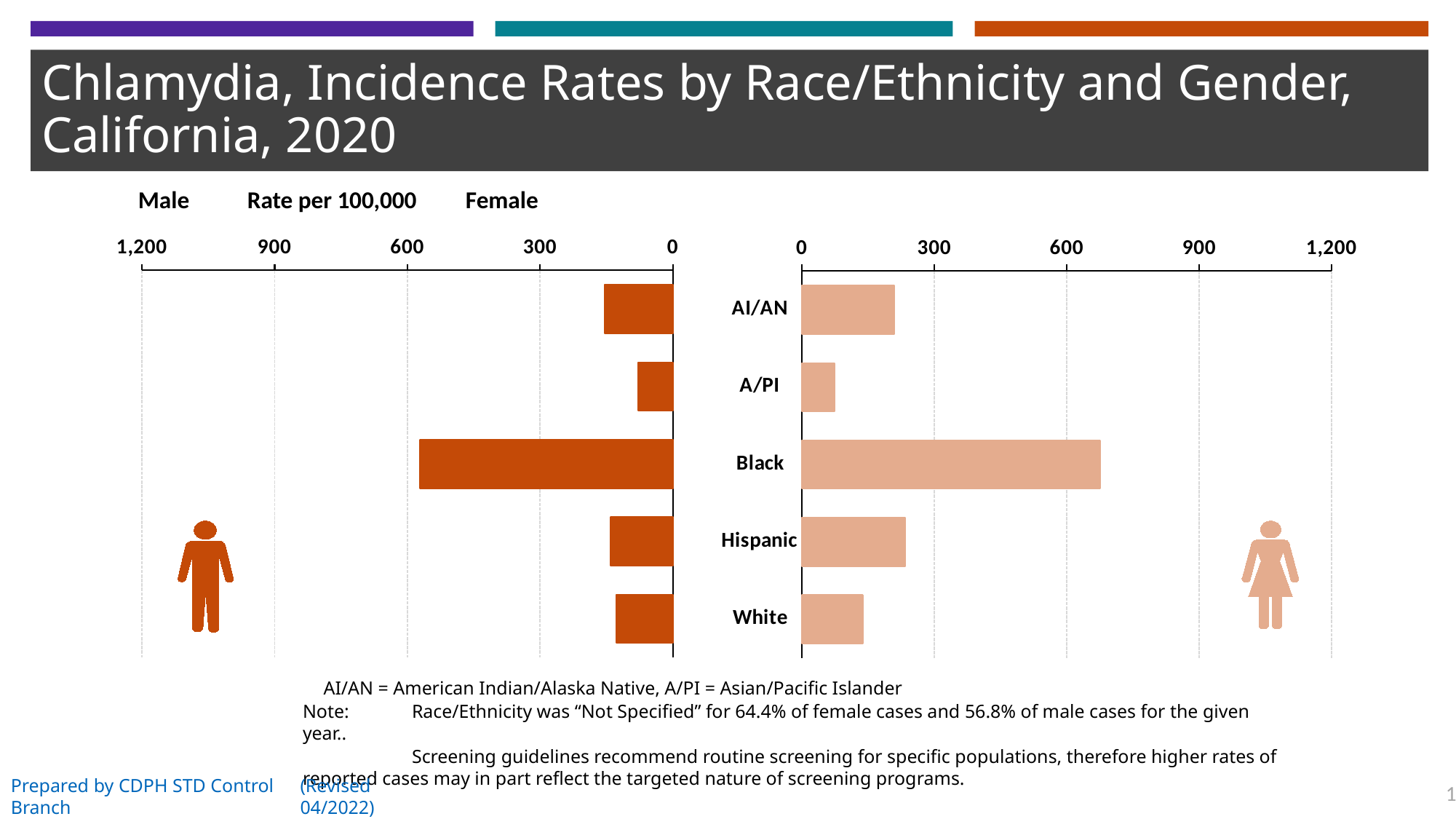
Is the female rate for Hispanic greater or less than 300? less Which is larger, the female rate for White or the female rate for A/PI? female rate for White Is the female rate for Black greater or less than 600? greater Which is larger, the female rate for Black or the male rate for Black? female rate for Black Is the male rate for Black greater or less than 300? greater Which race/ethnicity has the lowest female chlamydia incidence rate? A/PI What unit is the rate expressed in, according to the chart's axis label? Rate per 100,000 How many race/ethnicity categories are plotted in the chart? 5 Which race/ethnicity has the highest female chlamydia incidence rate? Black What kind of chart is shown on the slide? bar chart Which race/ethnicity has the lowest male chlamydia incidence rate? A/PI Which race/ethnicity has the highest male chlamydia incidence rate? Black